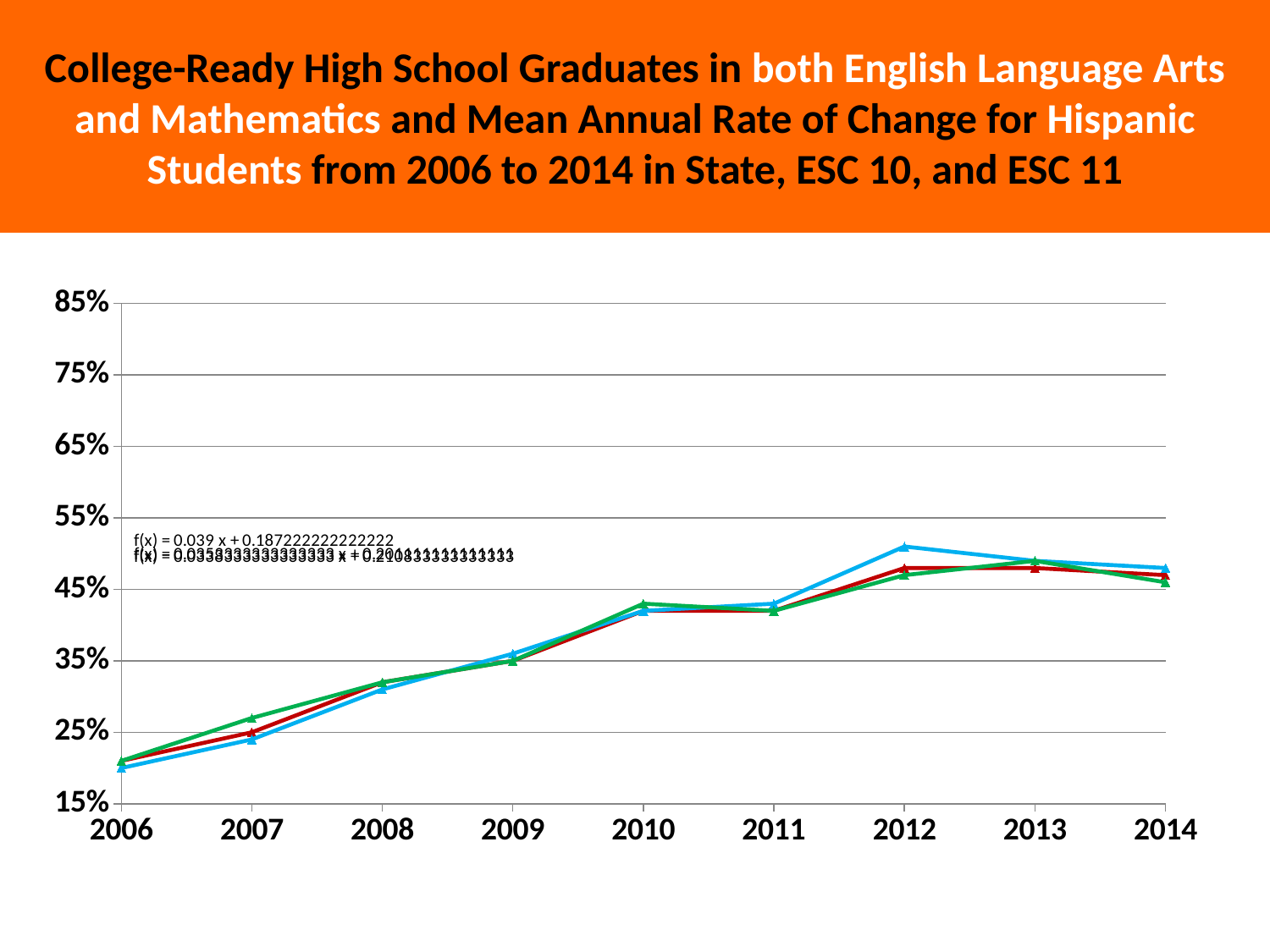
What is the highest value labelled on the y axis? 85% Overall, do the plotted values rise or fall from 2006 to 2014? rise In 2010, are the values for all three lines greater or less than 35%? greater How many lines are plotted on the chart? 3 In 2009, are the values for all three lines greater or less than 45%? less Between 2013 and 2014, do the plotted lines rise or fall? fall In 2006, are the values for all three lines greater or less than 25%? less What kind of chart is shown on the slide? line chart How many years are shown along the x axis of the chart? 9 Which student group does the chart title say the data is for? Hispanic Students